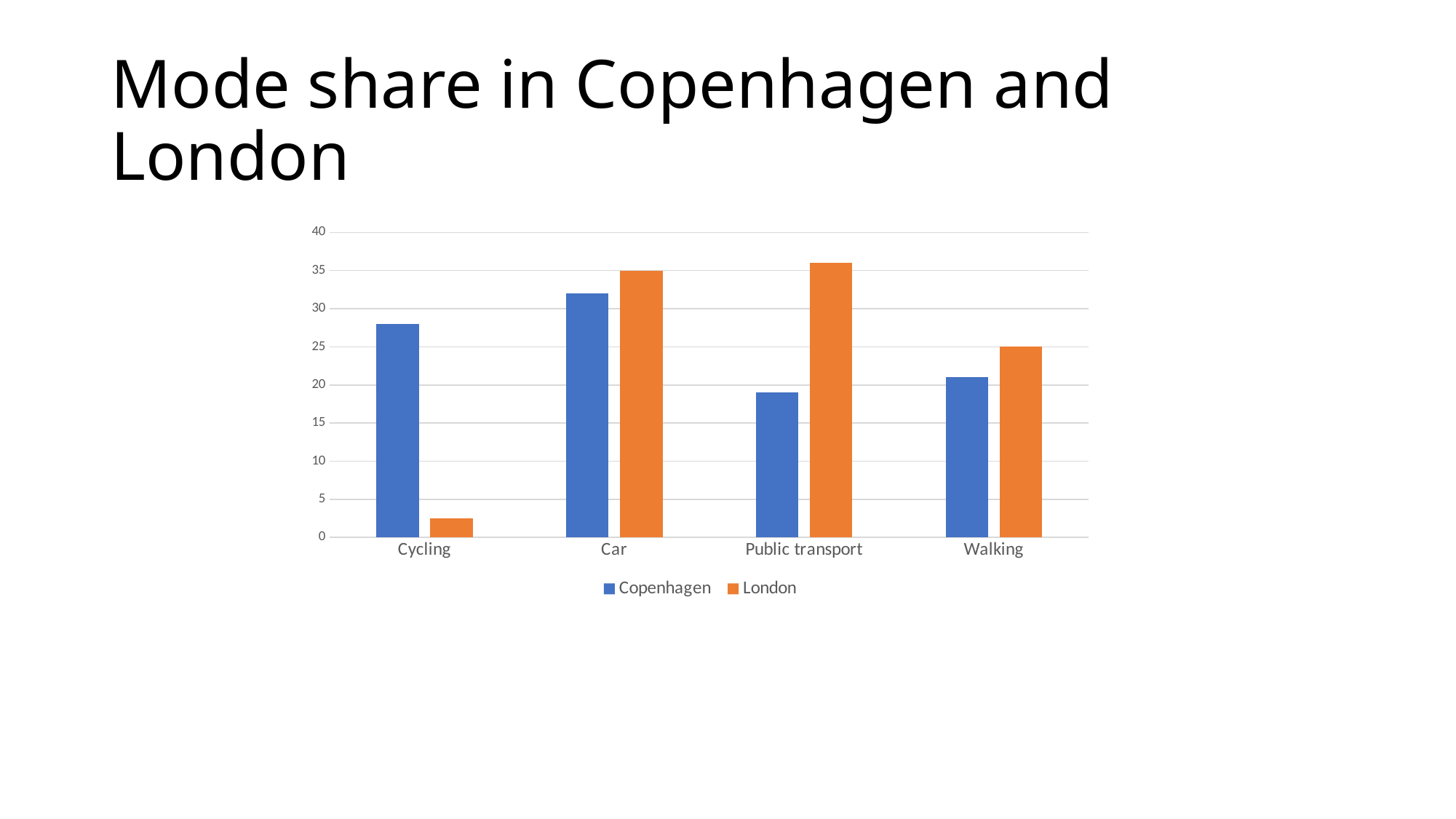
How many series does the legend list? 2 In the Public transport category, which is larger, Copenhagen or London? London What is the value for London in the Walking category? 25 Is the value for Copenhagen in the Cycling category greater or less than 25? greater Which category has the highest value for Copenhagen? Car Is the value for Copenhagen in the Public transport category greater or less than 20? less What is the value for London in the Car category? 35 What kind of chart is shown on the slide? bar chart Is the value for London in the Cycling category greater or less than 5? less How many categories are shown on the x axis? 4 Which series does the orange colour represent? London Which category has the lowest value for London? Cycling